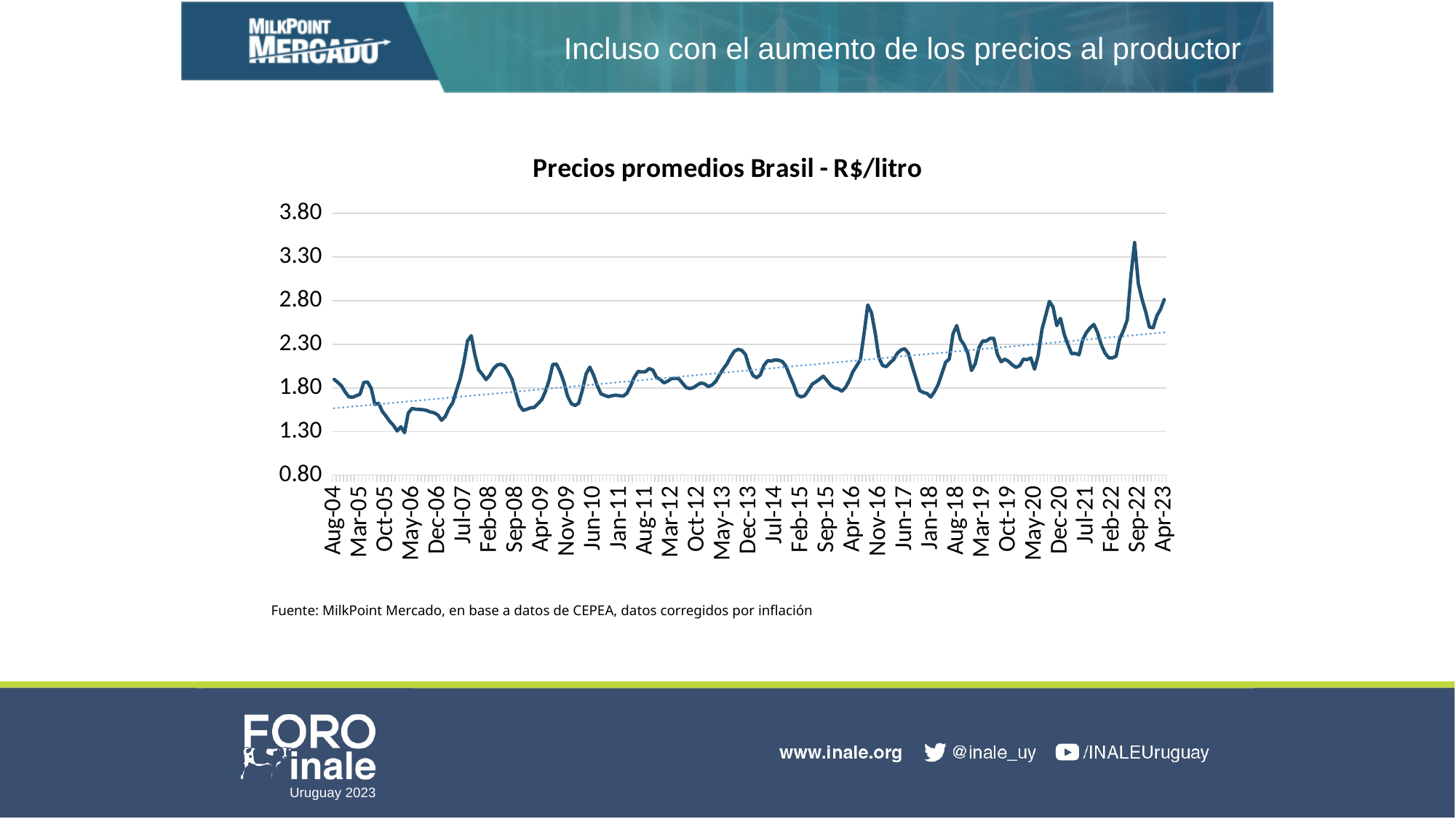
Is the value at Apr-23 greater or less than 2.30? greater Is the value near Jan-18 greater or less than 2.30? less Which is higher, the peak near Sep-22 or the peak near Jul-07? Sep-22 Is the peak value near Nov-16 greater or less than 2.30? greater Which is lower, the value near May-06 or the value near Apr-23? May-06 What is the title of the chart? Precios promedios Brasil - R$/litro Around which labelled month does the line reach its highest value? Sep-22 Over the whole period from Aug-04 to Apr-23, does the price line generally rise or fall? rise What kind of chart is shown on the slide? line chart What is the highest value shown on the vertical axis? 3.80